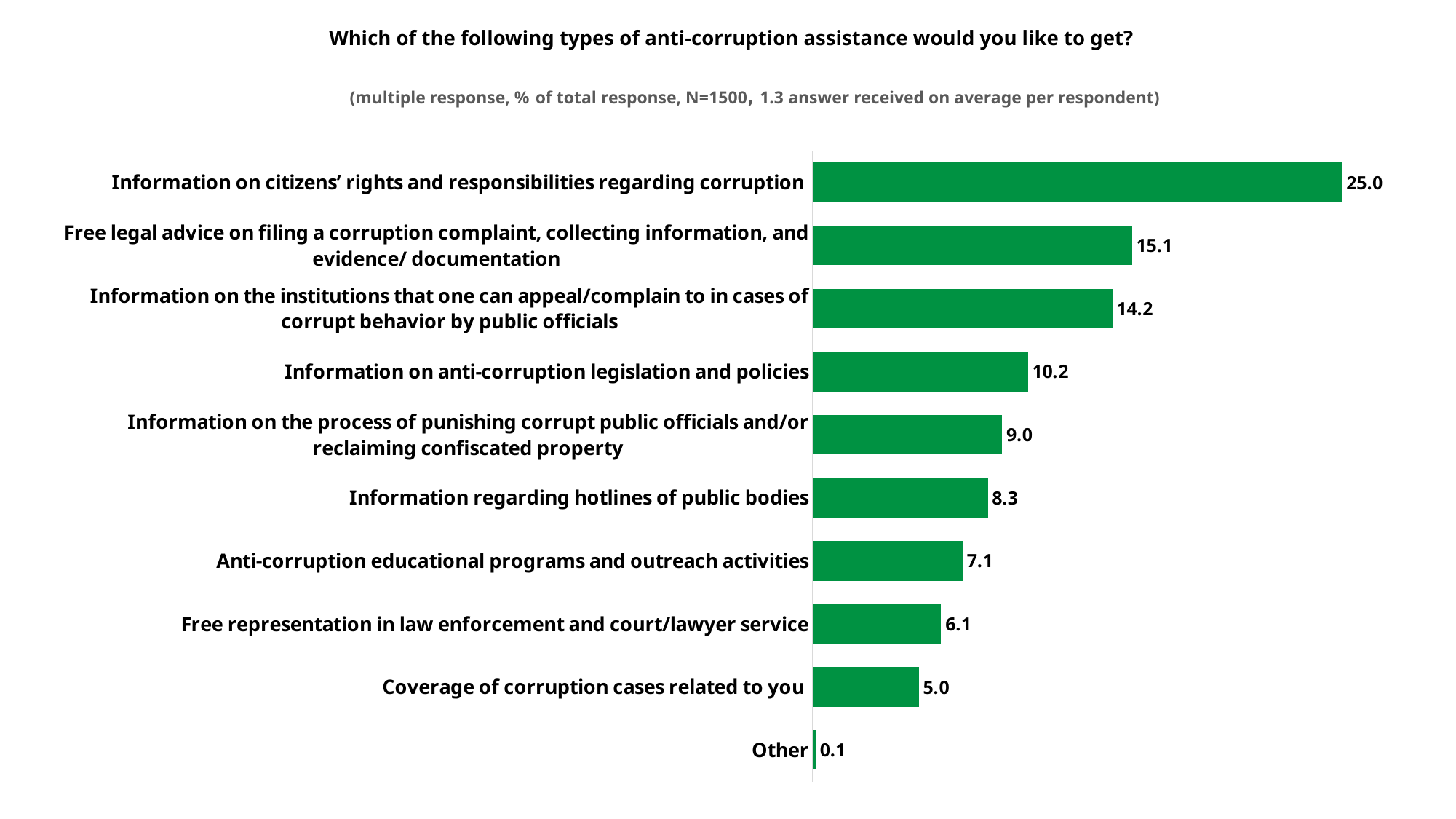
What is the sample size (N) stated in the chart subtitle? 1500 Which category has the lowest value? Other How many categories are shown in the chart? 10 What is the difference between the values for 'Free legal advice on filing a corruption complaint, collecting information, and evidence/ documentation' and 'Information on the institutions that one can appeal/complain to in cases of corrupt behavior by public officials'? 0.9 What kind of chart is shown on the slide? Bar chart What is the value for 'Information on citizens' rights and responsibilities regarding corruption'? 25.0 What is the value for 'Free representation in law enforcement and court/lawyer service'? 6.1 What colour are the bars in the chart? Green What is the difference between the values for 'Information on anti-corruption legislation and policies' and 'Coverage of corruption cases related to you'? 5.2 Which is larger: the value for 'Anti-corruption educational programs and outreach activities' or the value for 'Information on the process of punishing corrupt public officials and/or reclaiming confiscated property'? Information on the process of punishing corrupt public officials and/or reclaiming confiscated property What is the value for 'Information regarding hotlines of public bodies'? 8.3 Which category has the highest value? Information on citizens' rights and responsibilities regarding corruption